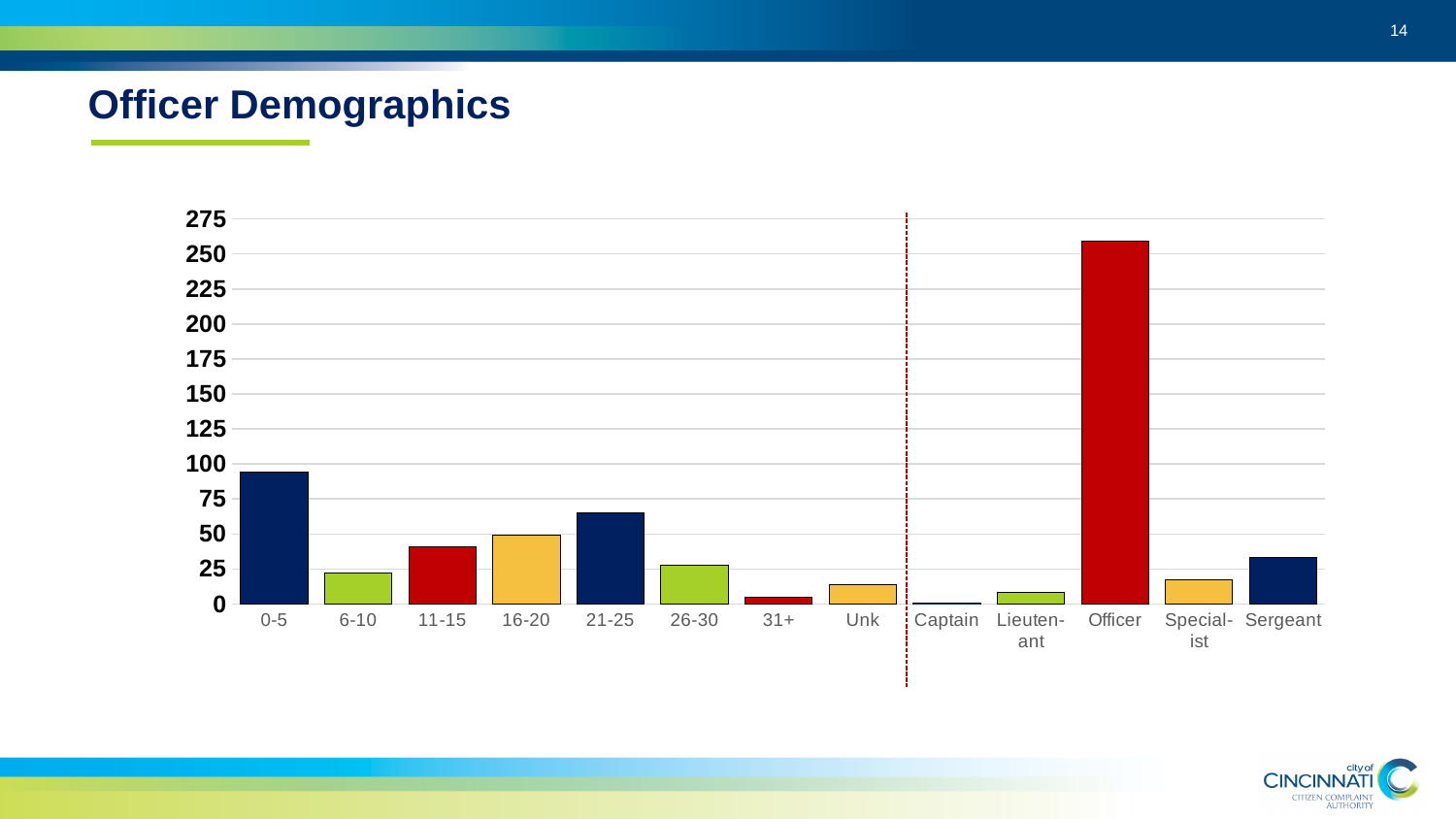
Which is larger, the value for 0-5 or the value for 21-25? 0-5 Which category has the lowest bar in the chart? Captain Is the value for Specialist greater or less than 25? less Is the value for Officer greater or less than 250? greater What is the title of the slide containing the chart? Officer Demographics Is the value for 0-5 greater or less than 75? greater What kind of chart is shown on the slide? bar chart How many categories are shown along the x axis of the chart? 13 Which is larger, the value for 16-20 or the value for 11-15? 16-20 Which category has the highest bar in the chart? Officer